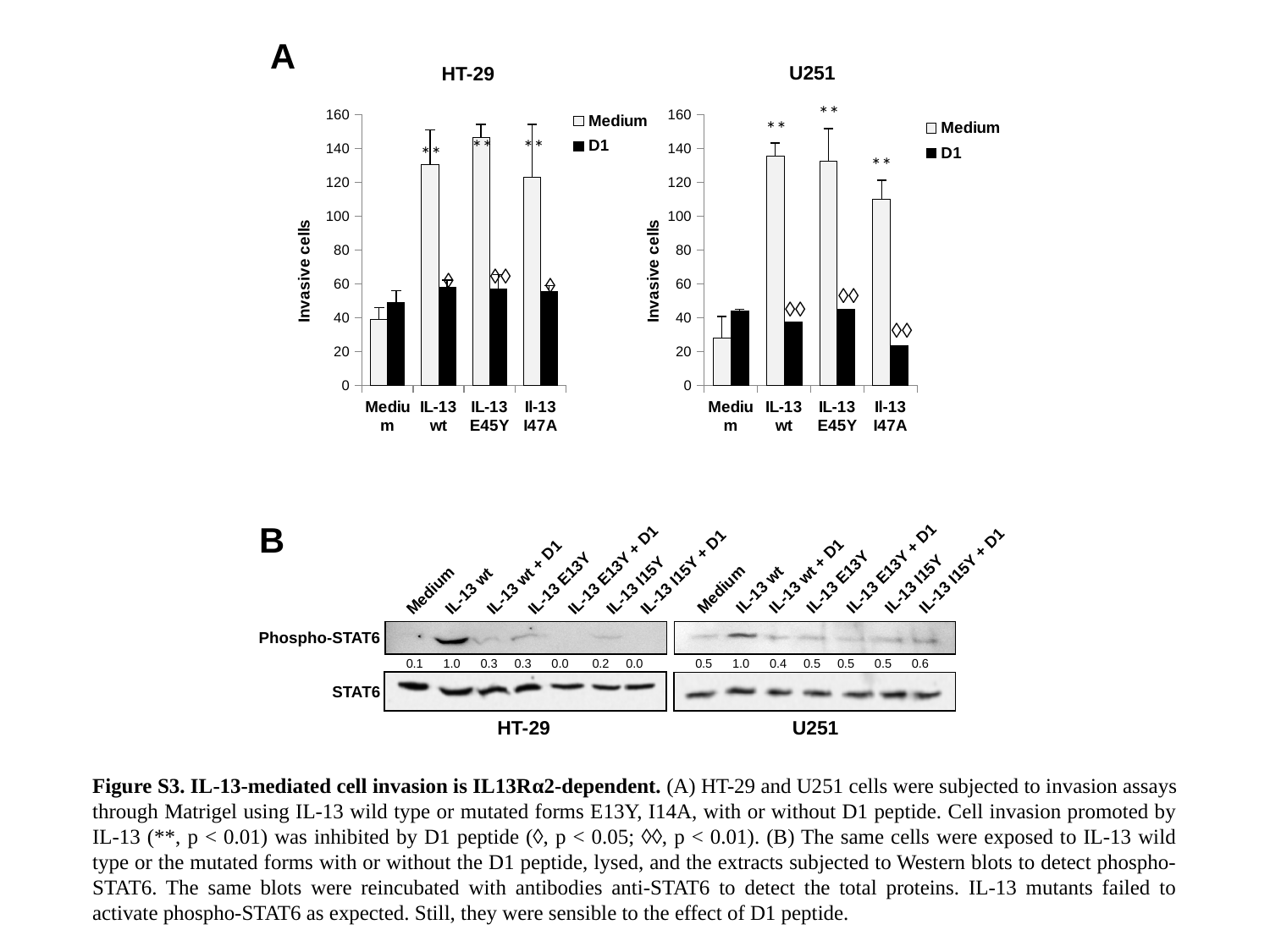
In the HT-29 chart, which category has the highest Medium series bar? IL-13 E45Y What is the y-axis title of the U251 chart? Invasive cells How many series does the legend of the HT-29 chart list? 2 In the HT-29 chart, is the Medium series value for IL-13 wt greater or less than 100? greater In the U251 chart, which category has the lowest D1 series bar? Il-13 I47A What kind of chart is the HT-29 chart? bar chart In the HT-29 chart, is the D1 series value for IL-13 wt greater or less than 80? less In the U251 chart, which is larger in the Medium series: IL-13 wt or Il-13 I47A? IL-13 wt In the U251 chart, is the Medium series value for the Medium category greater or less than 40? less How many categories are shown on the x axis of the U251 chart? 4 In the HT-29 chart, for the IL-13 wt category, which series has the larger bar: Medium or D1? Medium In the U251 chart, which category has the lowest Medium series bar? Medium